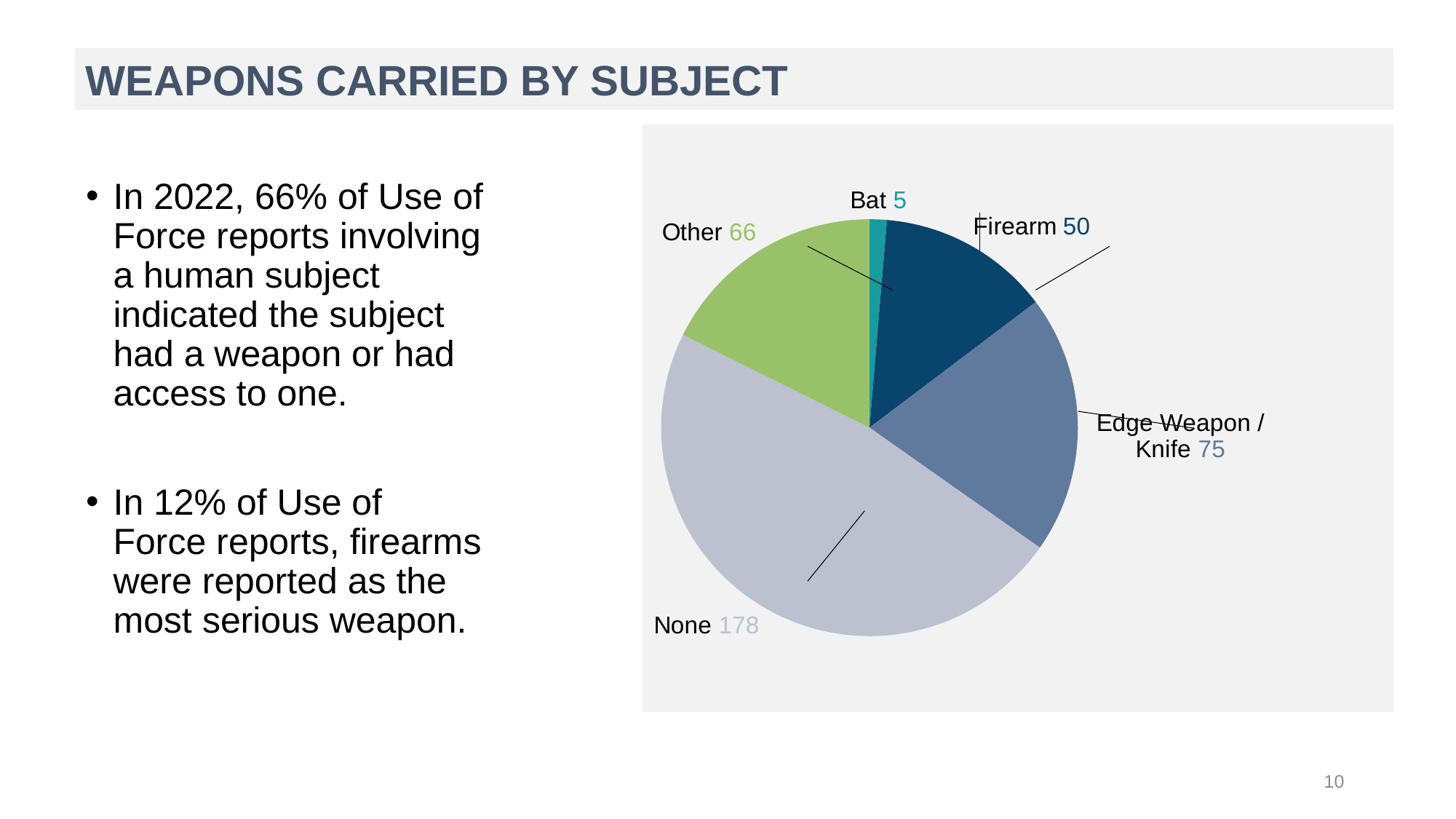
What is the value for None in the pie chart? 178 Which is larger, the value for Other or the value for Firearm? Other What is the total of all the slice values in the pie chart? 374 What type of chart is shown on the slide? pie chart What is the value for Firearm in the pie chart? 50 Which category has the largest slice in the pie chart? None Which category has the smallest slice in the pie chart? Bat What is the value for Bat in the pie chart? 5 What is the title of the slide containing the pie chart? WEAPONS CARRIED BY SUBJECT What is the difference between the values for Edge Weapon / Knife and Firearm? 25 How many slices does the pie chart have? 5 What is the value for Edge Weapon / Knife in the pie chart? 75